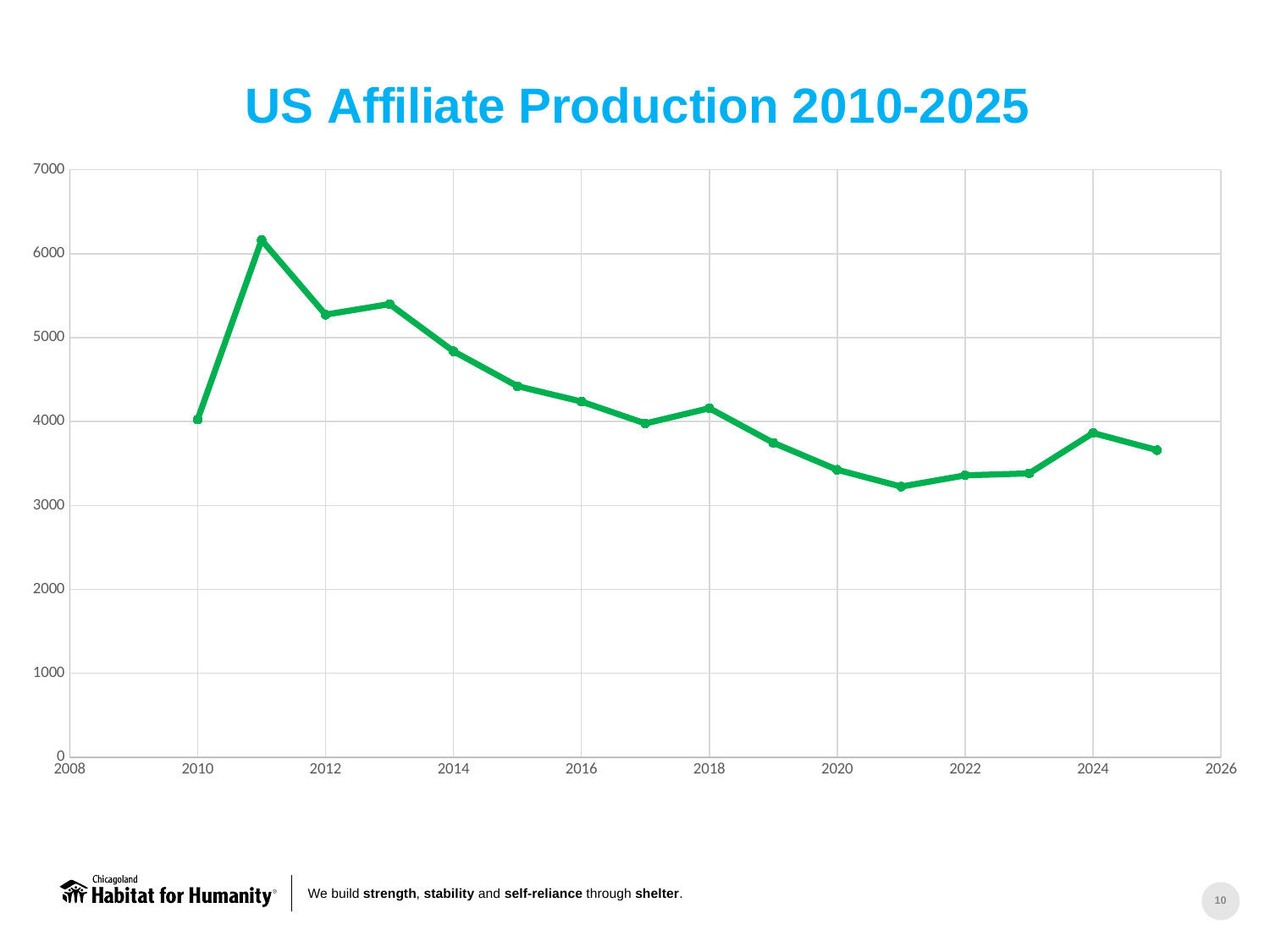
Is the value for 2013 greater or less than 5000? greater Which year has the highest value? 2011 Is the value for 2019 greater or less than 4000? less What kind of chart is shown on the slide? Line chart Which is larger, the value for 2024 or the value for 2025? 2024 Is the value for 2021 greater or less than 3000? greater Which is larger, the value for 2011 or the value for 2012? 2011 What is the title of the chart? US Affiliate Production 2010-2025 Which year has the lowest value? 2021 How many data points are plotted on the line? 16 Do the values generally rise or fall from 2011 to 2021? fall